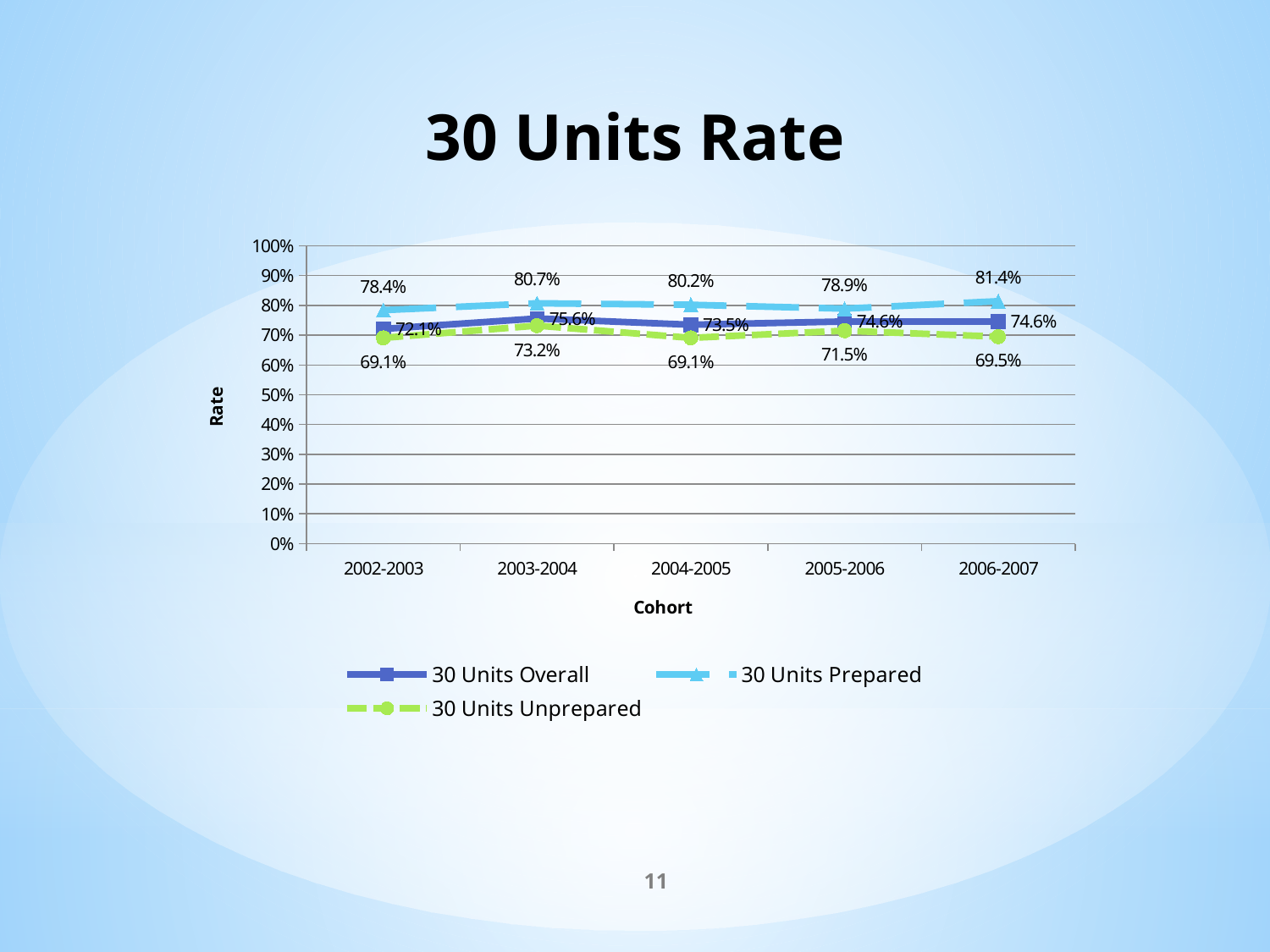
How many cohorts are plotted along the x axis? 5 What is the 30 Units Prepared rate for the 2006-2007 cohort? 81.4% Which cohort has the highest 30 Units Prepared rate? 2006-2007 What type of chart is shown on the slide? Line chart Which is larger for the 2005-2006 cohort: the 30 Units Overall rate or the 30 Units Unprepared rate? 30 Units Overall How many series does the legend list? 3 What is the 30 Units Overall rate for the 2002-2003 cohort? 72.1% Is the 30 Units Unprepared rate for the 2002-2003 cohort greater or less than 70%? less Which cohort has the lowest 30 Units Overall rate? 2002-2003 What is the 30 Units Unprepared rate for the 2003-2004 cohort? 73.2% What is the title of the chart? 30 Units Rate What is the difference between the 30 Units Prepared and 30 Units Unprepared rates for the 2004-2005 cohort? 11.1%